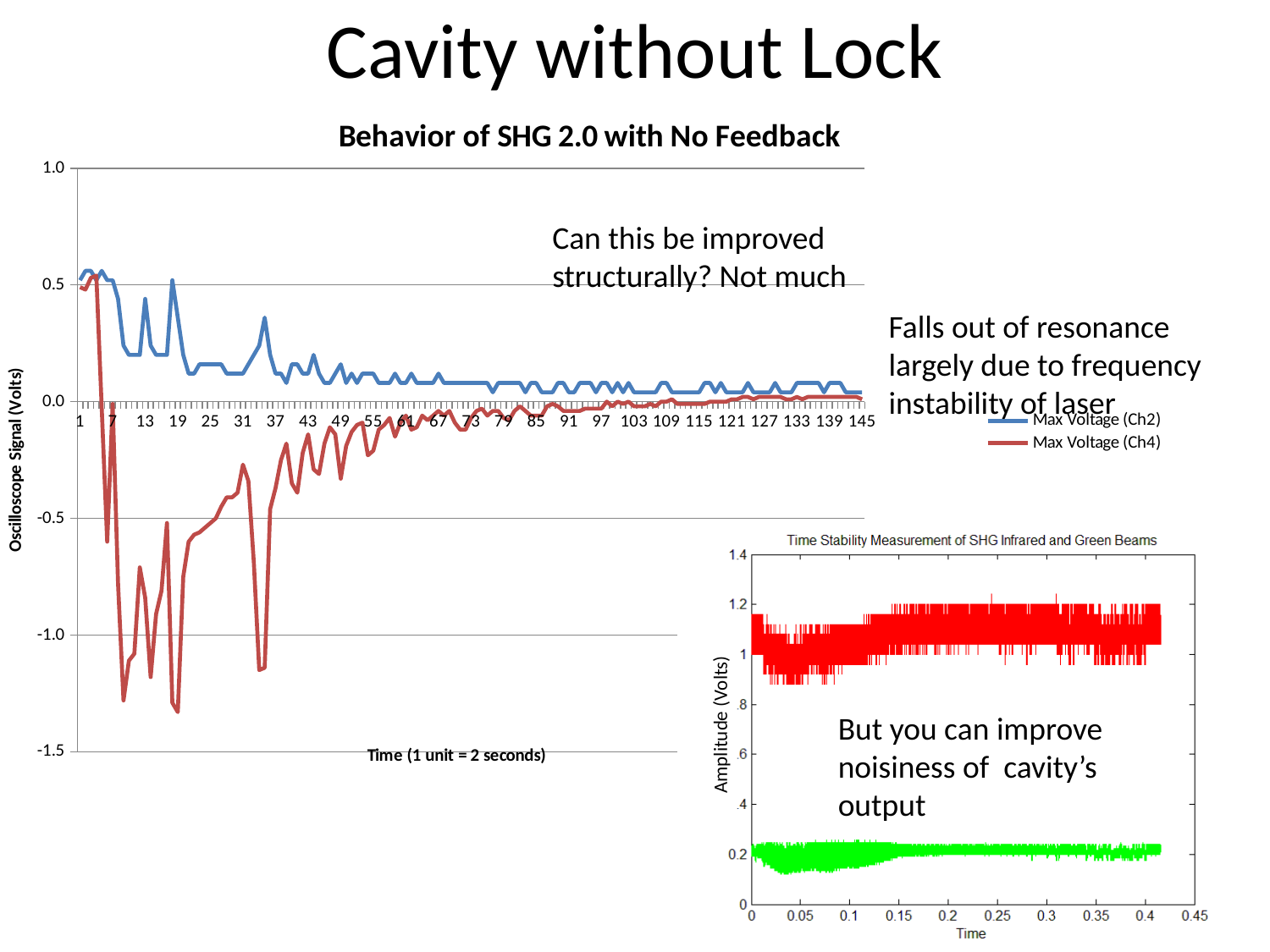
In "Behavior of SHG 2.0 with No Feedback", is the value of Max Voltage (Ch2) at time 37 greater or less than 0.5? less In "Behavior of SHG 2.0 with No Feedback", which series reaches the lowest value on the chart? Max Voltage (Ch4) What is the y-axis title of "Behavior of SHG 2.0 with No Feedback"? Oscilloscope Signal (Volts) How many series does the legend of "Behavior of SHG 2.0 with No Feedback" list? 2 In "Behavior of SHG 2.0 with No Feedback", which series is drawn in red? Max Voltage (Ch4) In "Behavior of SHG 2.0 with No Feedback", is the lowest value of Max Voltage (Ch4) greater or less than -1.0? less In "Time Stability Measurement of SHG Infrared and Green Beams", is the red trace greater or less than 0.8 volts throughout? greater What kind of chart is "Behavior of SHG 2.0 with No Feedback"? line chart In "Time Stability Measurement of SHG Infrared and Green Beams", which trace has the larger amplitude, the red or the green? red In "Behavior of SHG 2.0 with No Feedback", at time 7, which series has the larger value, Max Voltage (Ch2) or Max Voltage (Ch4)? Max Voltage (Ch2)